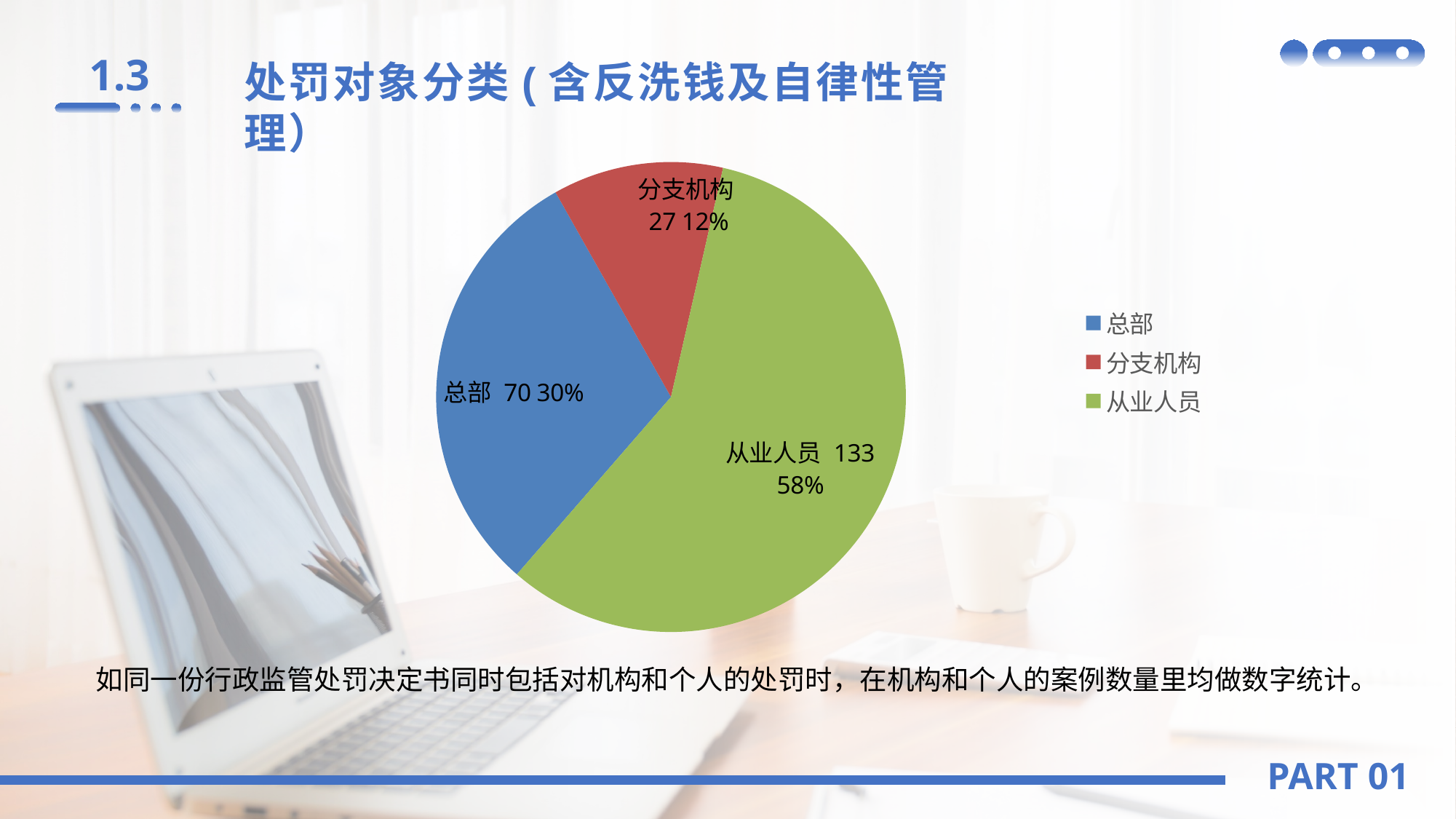
Which colour represents 总部 in the pie chart? blue What is the value for 从业人员? 133 What is the difference between the values for 从业人员 and 总部? 63 Which category has the smallest slice? 分支机构 Which category has the largest slice? 从业人员 What share of the pie does 从业人员 represent? 58% How many slices does the pie chart have? 3 What is the value for 总部? 70 What is the value for 分支机构? 27 What kind of chart is shown on the slide? pie chart What share of the pie does 分支机构 represent? 12% How many entries does the legend list? 3